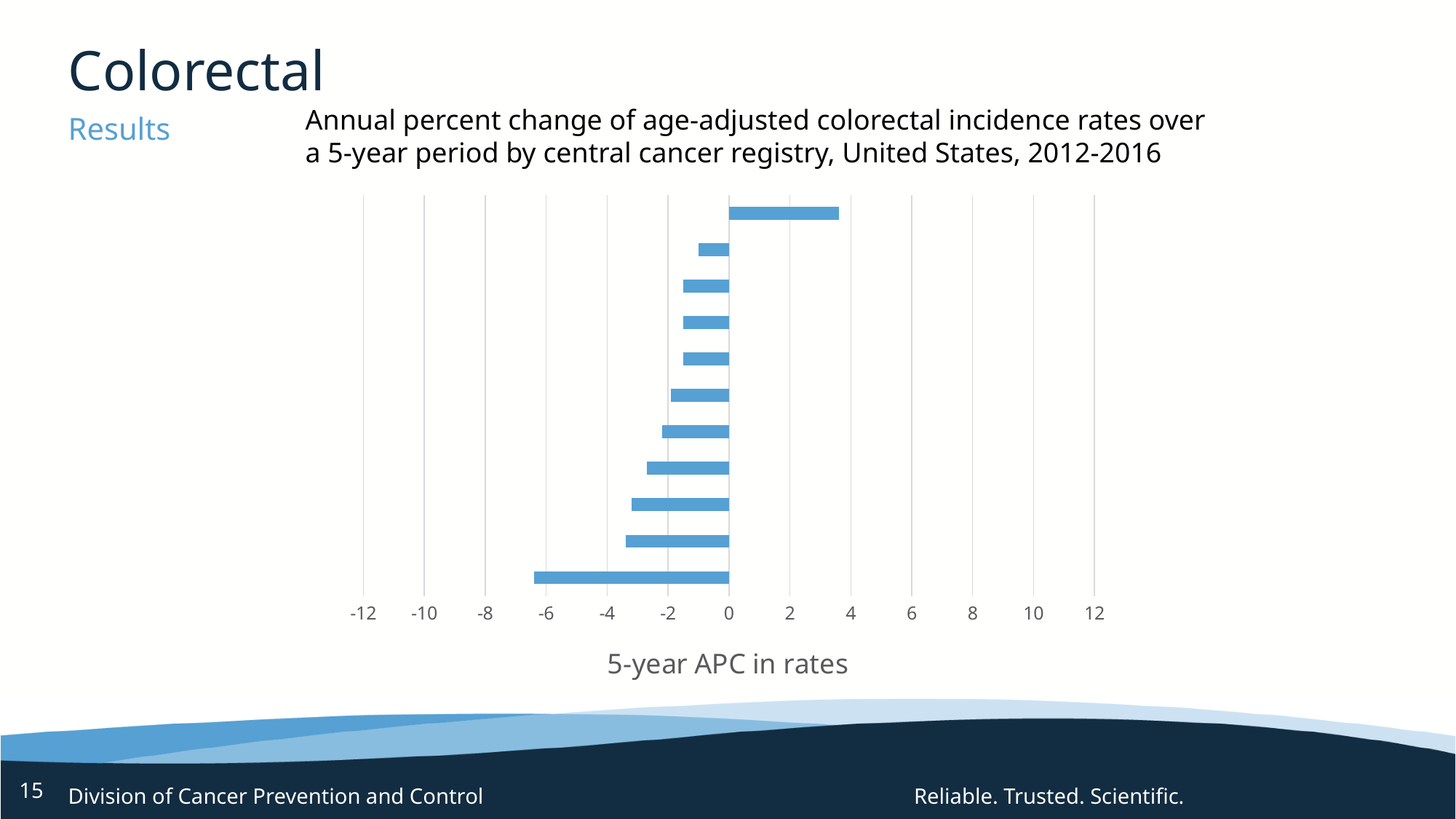
Which bar has the highest value, the top bar or the bottom bar? the top bar Is the value of the top bar in the chart greater or less than 4? less Is the value of the top bar in the chart greater or less than 2? greater What kind of chart is shown on the slide? bar chart What is the label of the horizontal axis of the chart? 5-year APC in rates How many bars are plotted in the chart? 11 Is the value of the second bar from the top greater or less than -2? greater What is the title of the chart? Annual percent change of age-adjusted colorectal incidence rates over a 5-year period by central cancer registry, United States, 2012-2016 Which bar has the lowest value, the top bar or the bottom bar? the bottom bar How many bars in the chart have a negative value? 10 How many bars in the chart have a positive value? 1